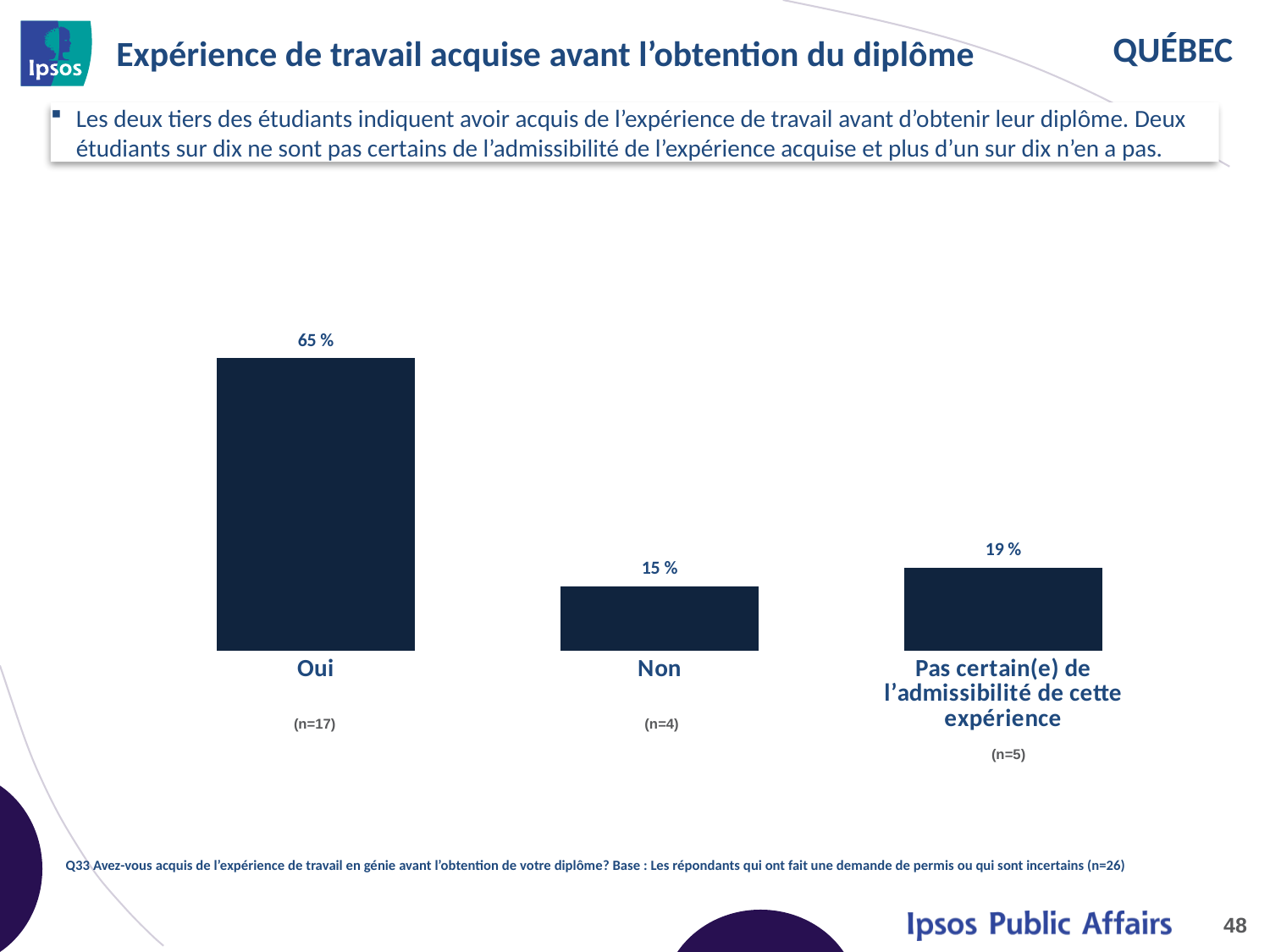
What is the value for "Non"? 15 % Which is larger, the value for "Non" or the value for "Pas certain(e) de l'admissibilité de cette expérience"? Pas certain(e) de l'admissibilité de cette expérience What is the value for "Oui"? 65 % What is the difference between the values for "Pas certain(e) de l'admissibilité de cette expérience" and "Non"? 4 % What is the difference between the values for "Oui" and "Non"? 50 % What is the title of the slide containing the chart? Expérience de travail acquise avant l'obtention du diplôme Which category has the lowest value? Non How many categories are shown in the chart? 3 What is the sample size (n) shown under the "Oui" bar? n=17 Which category has the highest value? Oui What kind of chart is shown on the slide? Bar chart What is the value for "Pas certain(e) de l'admissibilité de cette expérience"? 19 %